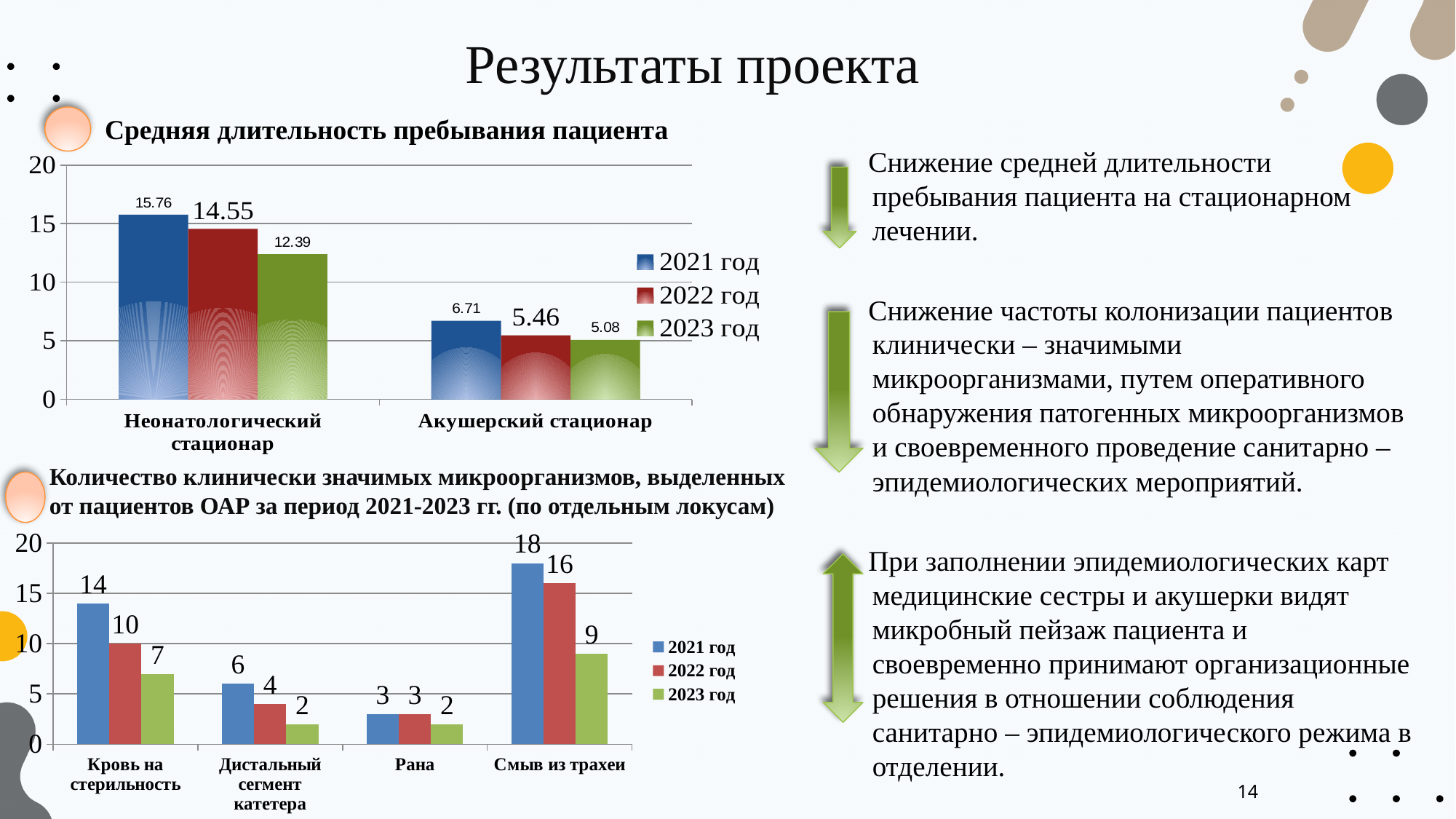
In the top chart (Средняя длительность пребывания пациента), how many series does the legend list? 3 In the top chart (Средняя длительность пребывания пациента), what is the value for 2021 год in Неонатологический стационар? 15.76 In the top chart (Средняя длительность пребывания пациента), what is the value for 2023 год in Акушерский стационар? 5.08 What type of chart is the bottom chart (Количество клинически значимых микроорганизмов)? Bar chart In the top chart (Средняя длительность пребывания пациента), do the values for Акушерский стационар rise or fall from 2021 год to 2023 год? fall In the top chart (Средняя длительность пребывания пациента), what is the difference between the 2021 год and 2023 год values for Неонатологический стационар? 3.37 In the bottom chart (Количество клинически значимых микроорганизмов), what is the value for 2022 год for Смыв из трахеи? 16 In the bottom chart (Количество клинически значимых микроорганизмов), which category has the highest value for 2021 год? Смыв из трахеи In the bottom chart (Количество клинически значимых микроорганизмов), what is the difference between the 2021 год and 2023 год values for Кровь на стерильность? 7 In the bottom chart (Количество клинически значимых микроорганизмов), how many categories are shown on the x axis? 4 In the bottom chart (Количество клинически значимых микроорганизмов), which category has the lowest value for 2023 год? Дистальный сегмент катетера and Рана (both 2) In the bottom chart (Количество клинически значимых микроорганизмов), which is larger: the 2022 год value for Кровь на стерильность or the 2022 год value for Дистальный сегмент катетера? Кровь на стерильность